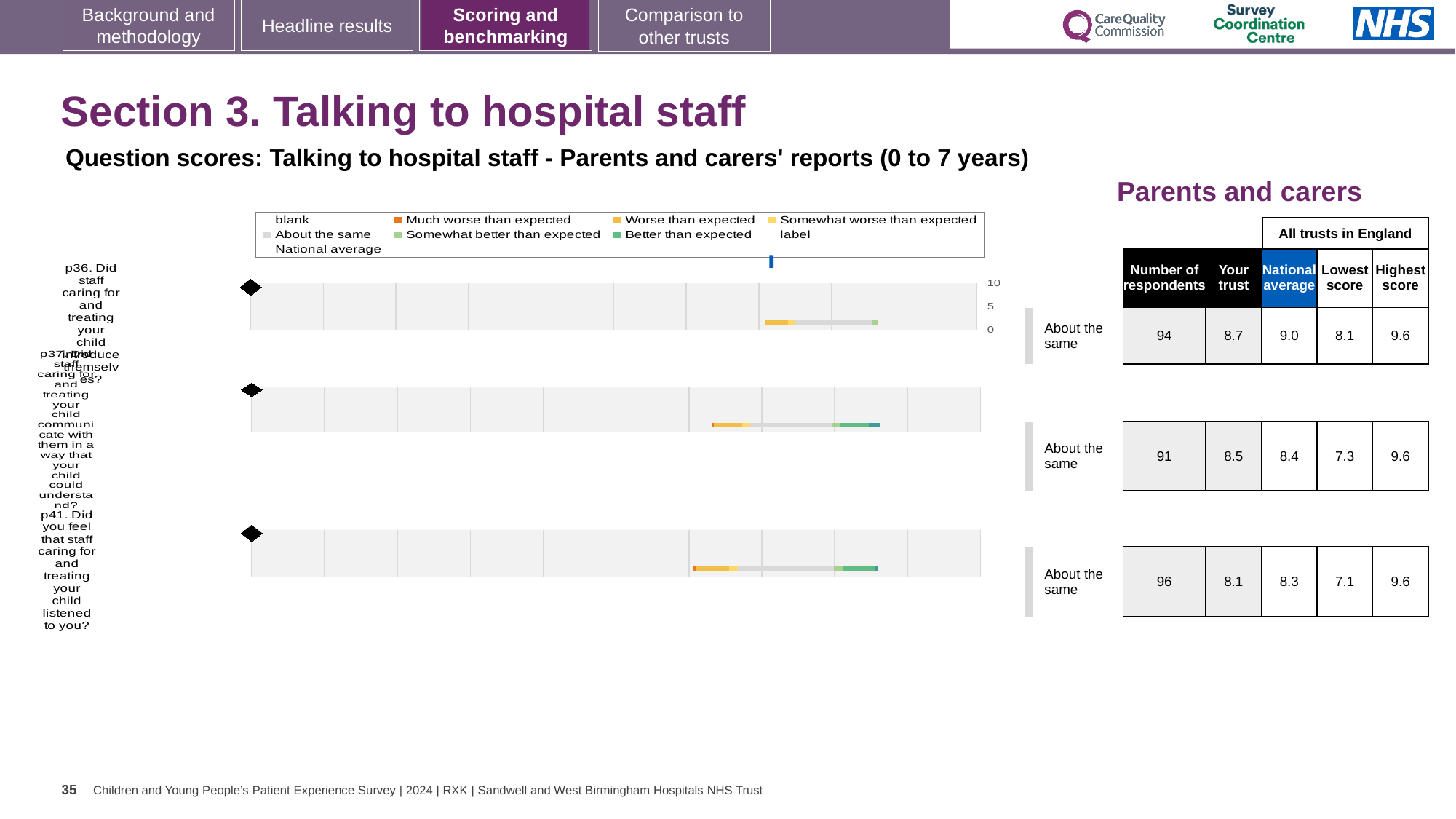
What is the National average score for p37 (Did staff communicate with them in a way that your child could understand)? 8.4 For p37, which is larger: the 'Your trust' score or the National average? Your trust What is the 'Your trust' score for p36 (Did staff caring for and treating your child introduce themselves)? 8.7 Which question has the highest 'Your trust' score? p36 What benchmark category is shown for each of the three questions? About the same What is the Highest score across all trusts in England for p36? 9.6 How many questions (categories) are plotted in the chart? 3 How many respondents answered p41 (Did you feel that staff caring for and treating your child listened to you)? 96 How many entries does the chart legend list? 9 Which question has the lowest 'Lowest score' among all trusts in England? p41 What is the difference between the National average and the 'Your trust' score for p36? 0.3 What kind of chart is used to show the question scores for Talking to hospital staff? bar chart